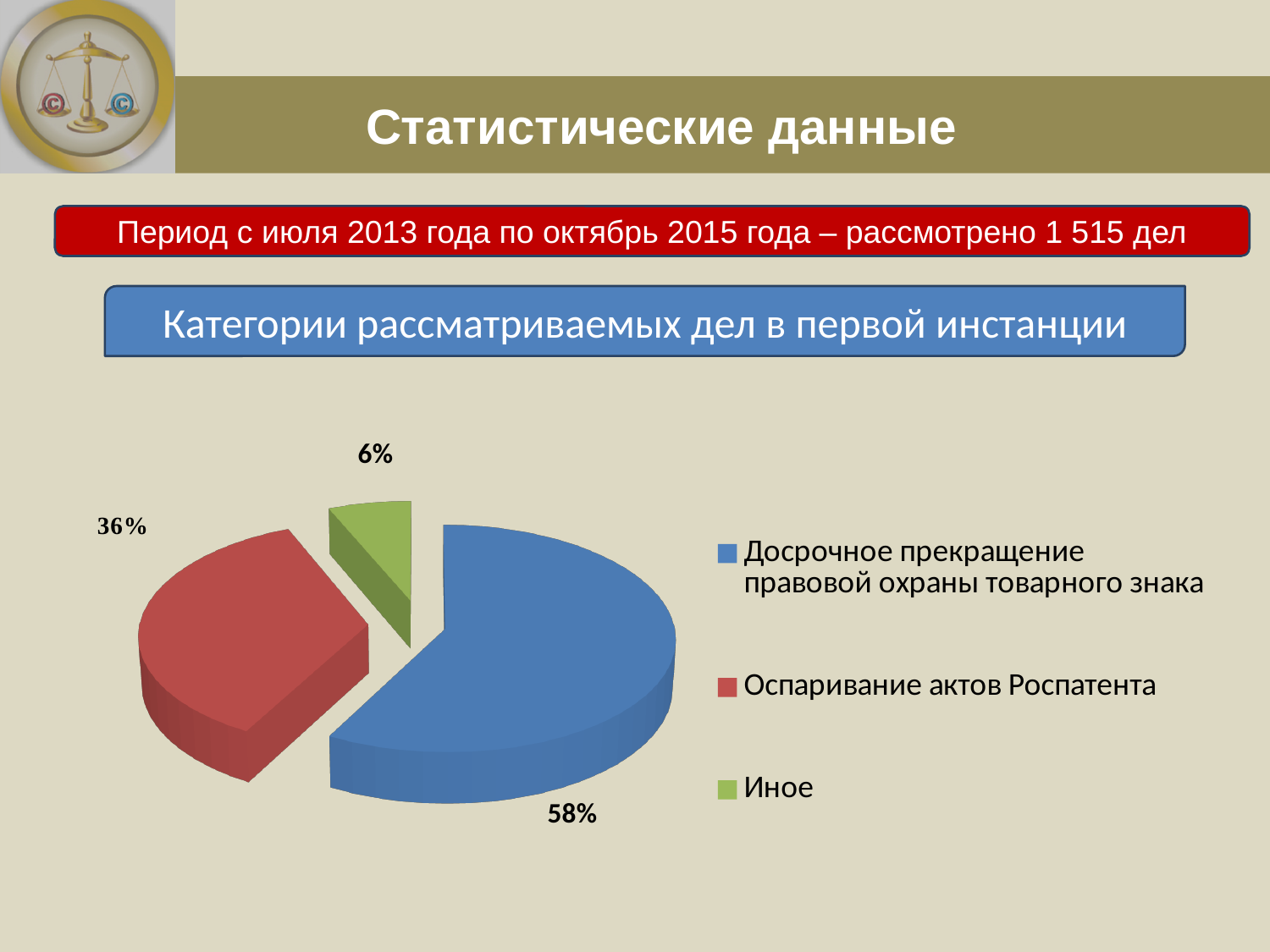
What share of the pie does "Иное" have? 6% What share of the pie does "Оспаривание актов Роспатента" have? 36% Which category has the smallest slice of the pie? Иное What is the difference in percentage points between "Досрочное прекращение правовой охраны товарного знака" and "Оспаривание актов Роспатента"? 22 What share of the pie does "Досрочное прекращение правовой охраны товарного знака" have? 58% Which is larger: the share for "Оспаривание актов Роспатента" or the share for "Иное"? Оспаривание актов Роспатента Which category has the largest slice of the pie? Досрочное прекращение правовой охраны товарного знака How many categories does the pie chart show? 3 What is the title shown above the chart? Категории рассматриваемых дел в первой инстанции How many entries does the legend list? 3 What kind of chart is shown on the slide? Pie chart What colour is the slice for "Оспаривание актов Роспатента"? Red